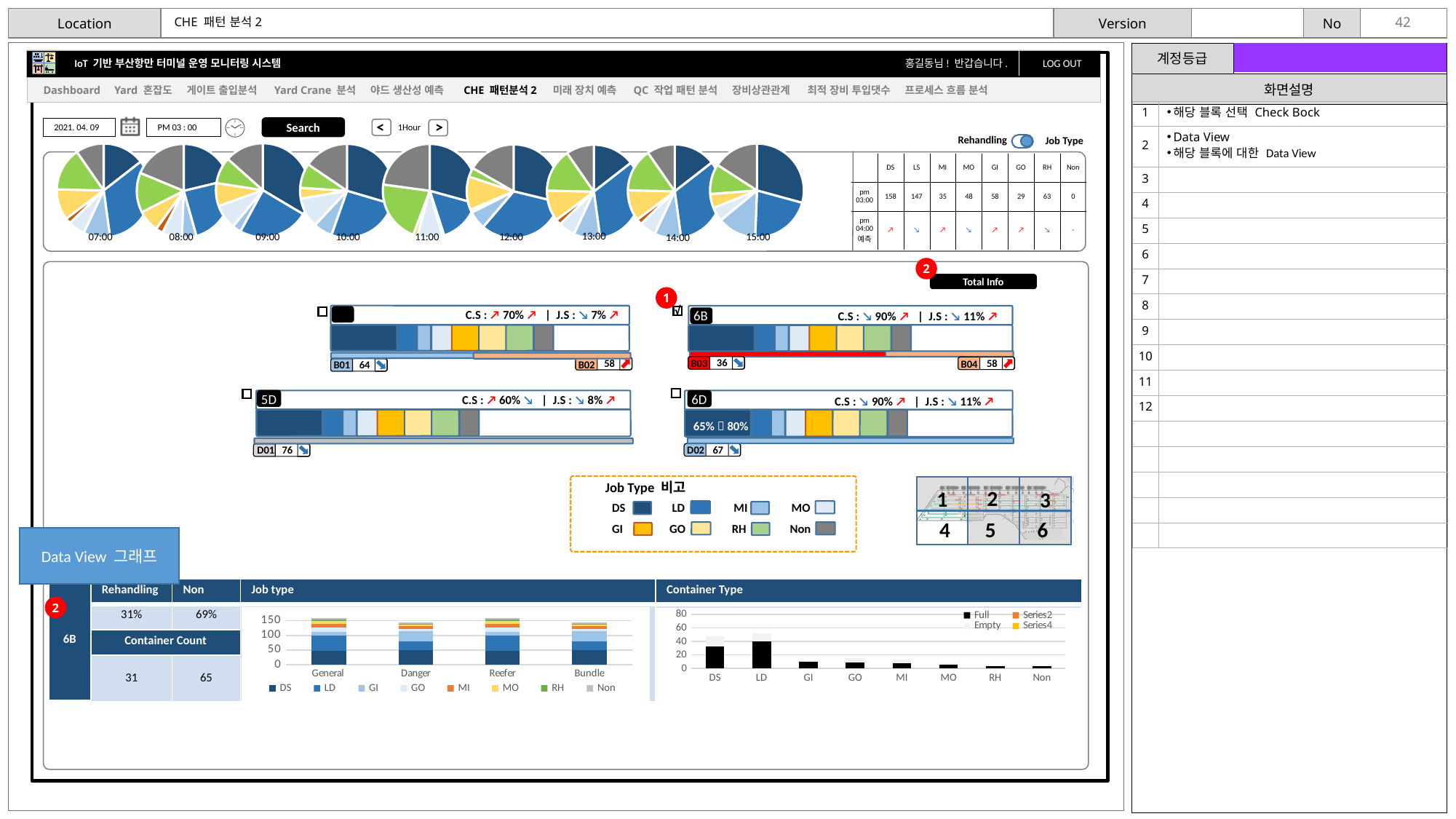
How many categories are shown on the x axis of the "Container Type" chart? 8 How many series does the legend of the "Job type" chart list? 8 What kind of chart is the "Container Type" chart at the bottom right of the slide? bar chart In the "Container Type" chart, is the Full bar for DS greater or less than 40? less How many categories are shown on the x axis of the "Job type" chart? 4 In the "Container Type" chart, which has the larger Full bar, DS or LD? LD What kind of chart is the "Job type" chart at the bottom of the slide? bar chart In the "Job type" chart, is the total of the stacked bar for General greater or less than 100? greater How many entries does the legend of the "Container Type" chart list? 4 How many pie charts are shown in the row of hourly pie charts at the top of the dashboard? 9 In the "Job type" chart, is the total of the stacked bar for Danger greater or less than 150? less In the "Container Type" chart, which category has the tallest Full bar? LD